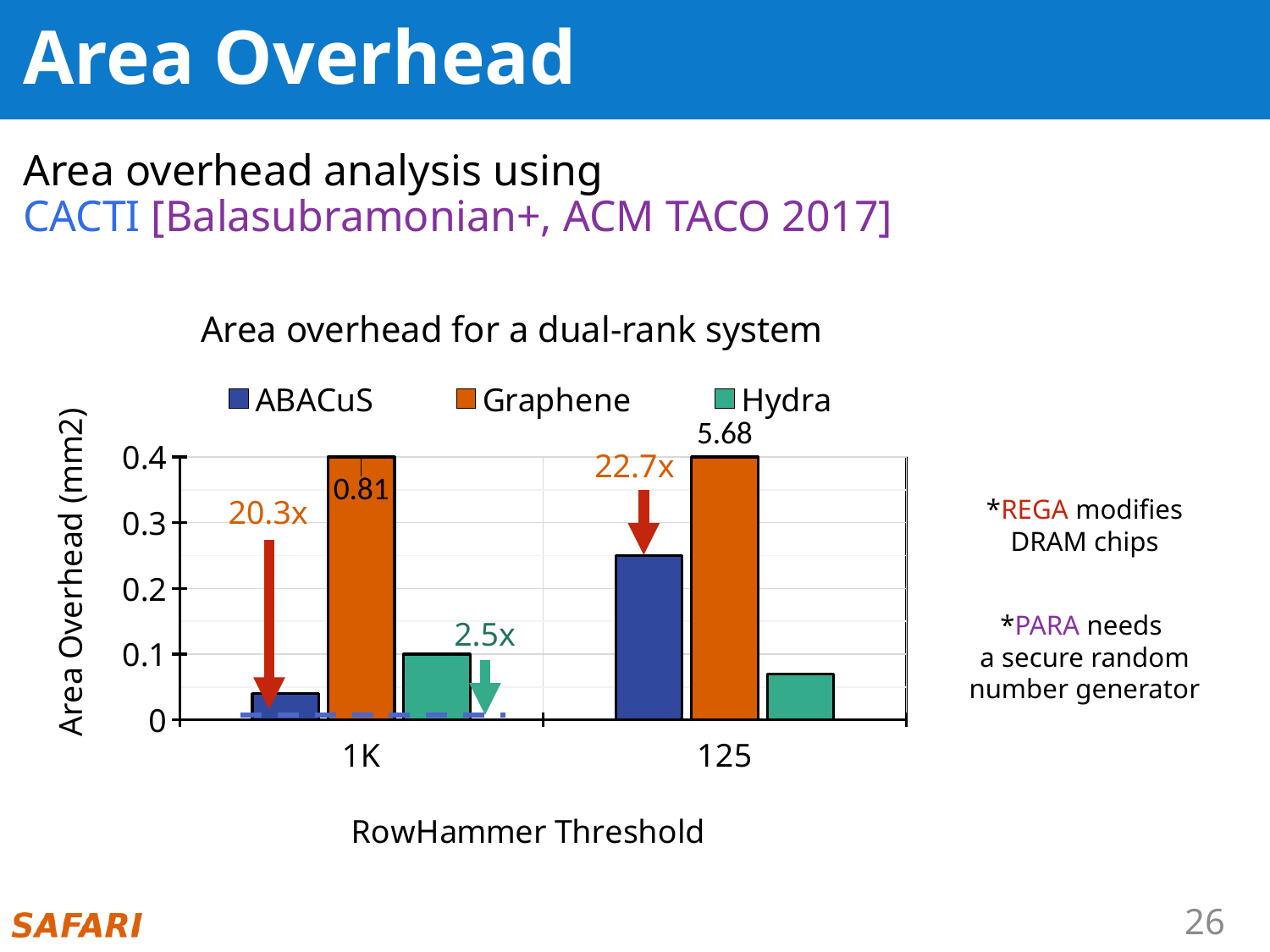
At a RowHammer Threshold of 125, which has the larger area overhead, ABACuS or Hydra? ABACuS How many RowHammer Threshold categories are shown on the x axis? 2 Which mechanism has the lowest area overhead at a RowHammer Threshold of 1K? ABACuS What is the area overhead of Graphene at a RowHammer Threshold of 125? 5.68 What is the difference between Graphene's area overhead at 125 and at 1K? 4.87 What is the area overhead of Graphene at a RowHammer Threshold of 1K? 0.81 Which mechanism has the highest area overhead at a RowHammer Threshold of 125? Graphene Is the area overhead of ABACuS at a RowHammer Threshold of 1K greater or less than 0.1? less What is the title of the x axis? RowHammer Threshold How many series does the legend list? 3 Is the area overhead of ABACuS at a RowHammer Threshold of 125 greater or less than 0.2? greater What kind of chart is shown on the slide? bar chart